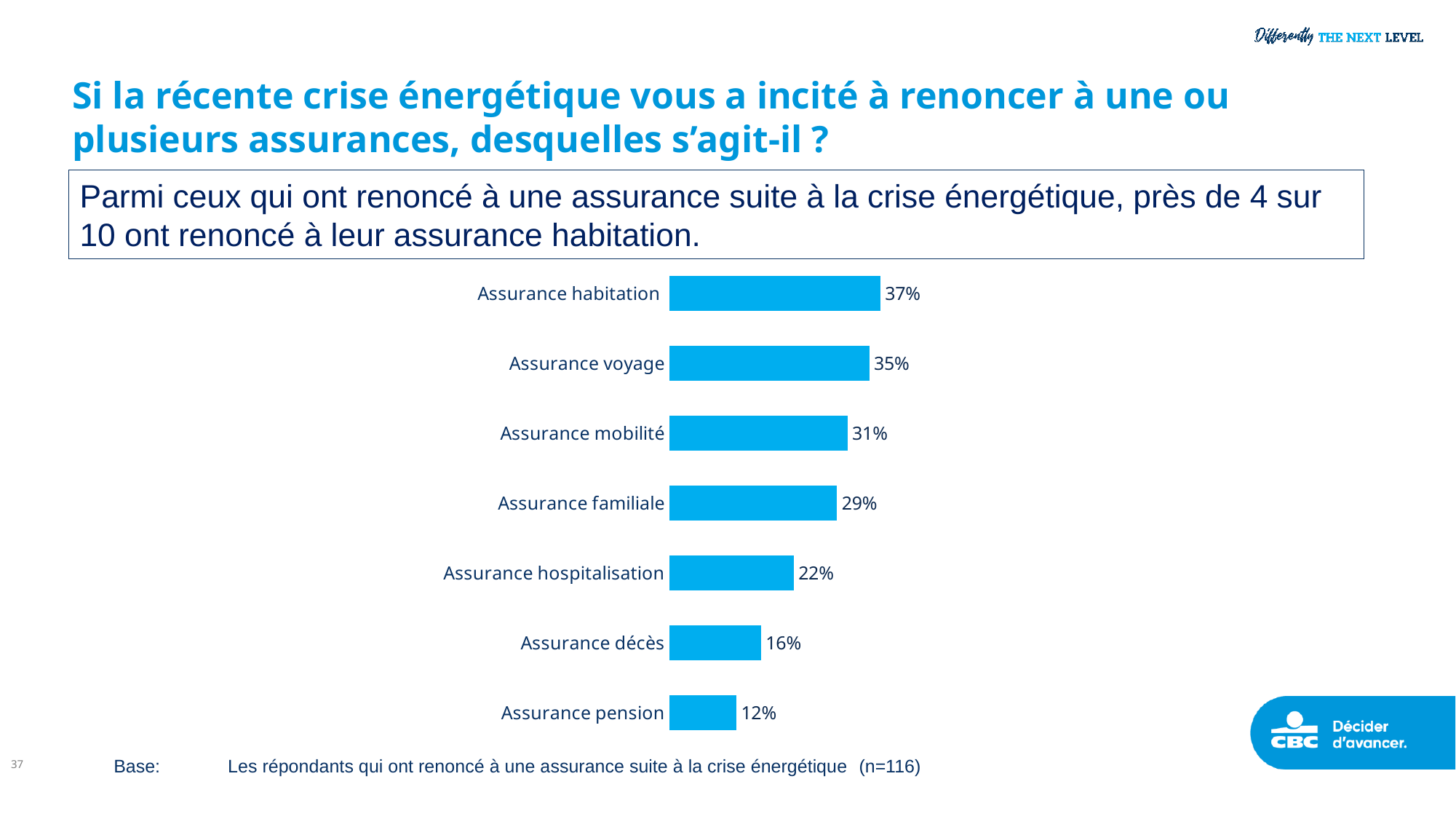
What is the sample size (n) given in the base note below the chart? n=116 What kind of chart is shown on the slide? Bar chart Which category has the lowest value? Assurance pension What is the value for Assurance habitation? 37% What is the difference between Assurance habitation and Assurance pension? 25% Do the values rise or fall from the top bar to the bottom bar? Fall What is the value for Assurance hospitalisation? 22% What is the difference between Assurance voyage and Assurance familiale? 6% What is the value for Assurance pension? 12% How many categories are shown in the chart? 7 Which is larger, Assurance mobilité or Assurance décès? Assurance mobilité Which category has the highest value? Assurance habitation